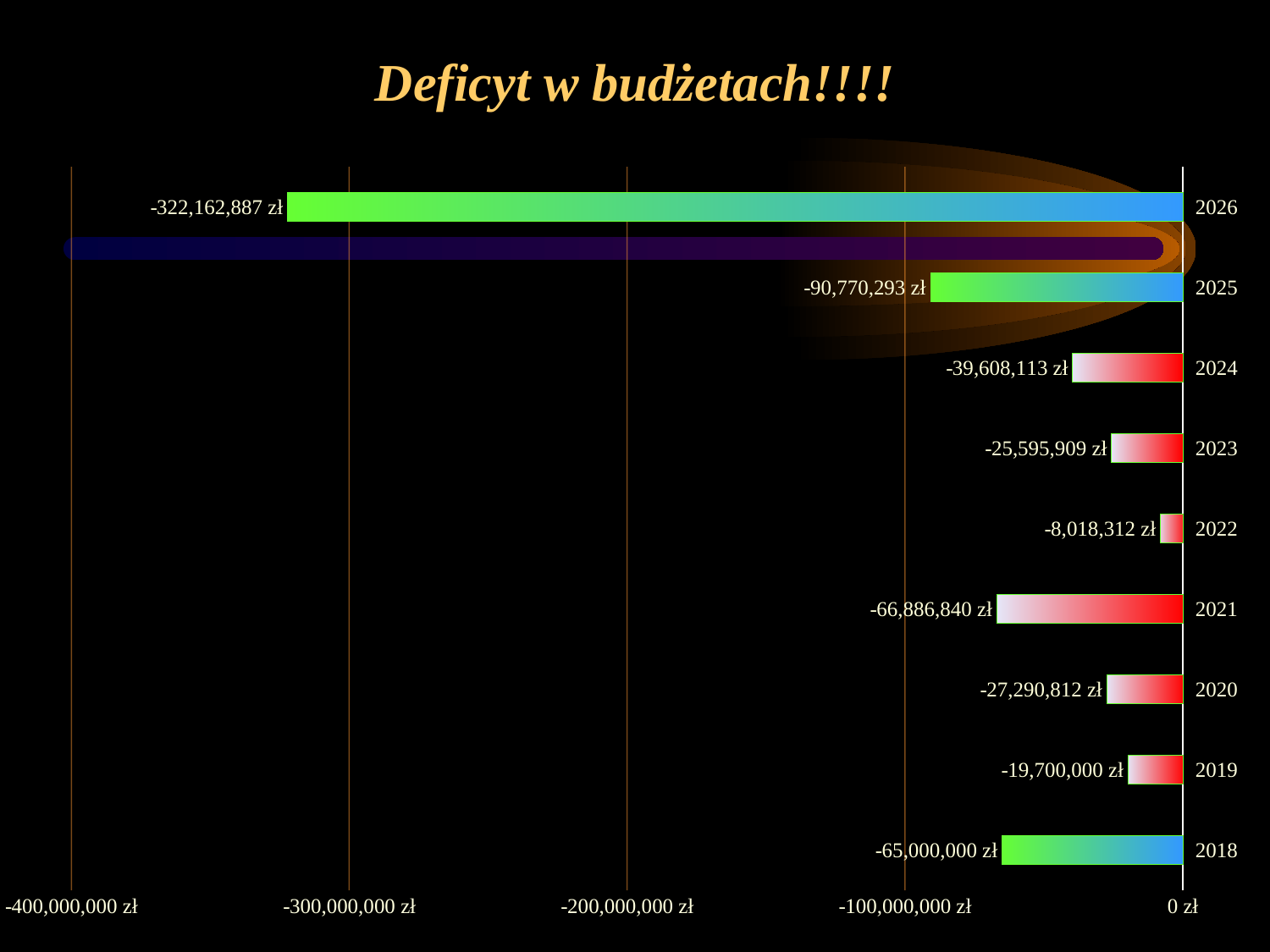
What is the difference between the deficit for 2026 and the deficit for 2025? 231,392,594 zł What is the value shown for 2026? -322,162,887 zł What kind of chart is shown on the slide? Bar chart How many years are plotted in the chart? 9 What is the title of the slide? Deficyt w budżetach!!!! What is the value shown for 2019? -19,700,000 zł By how much does the deficit for 2018 exceed the deficit for 2019? 45,300,000 zł Which year has the larger deficit, 2024 or 2020? 2024 What is the value shown for 2023? -25,595,909 zł Which year has the smallest deficit (the shortest bar)? 2022 What is the value shown for 2021? -66,886,840 zł Which year has the largest deficit (the longest bar)? 2026